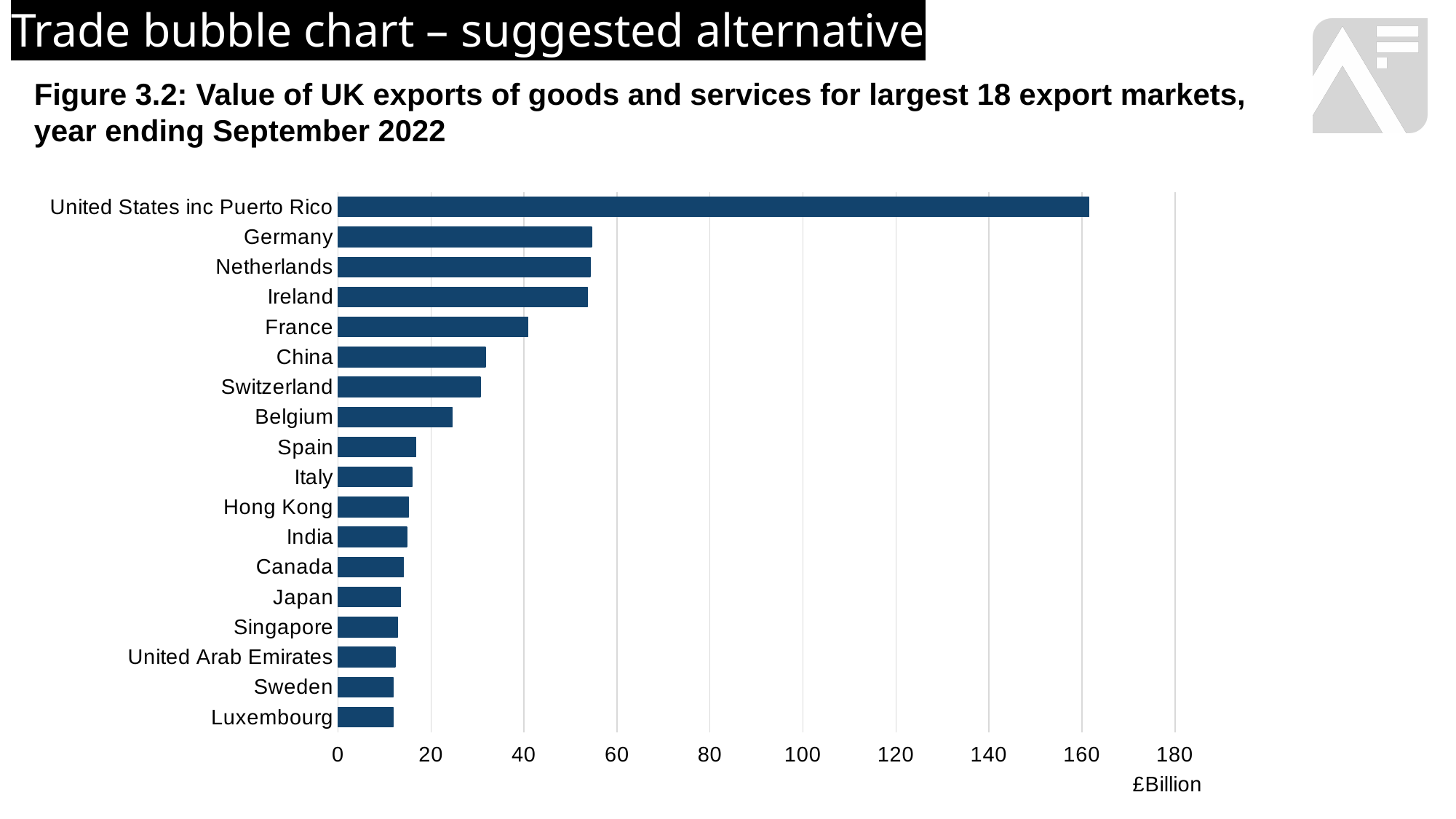
Which export market has the highest value of UK exports? United States inc Puerto Rico Is the value for United States inc Puerto Rico greater or less than 140? greater Is the value for France greater or less than 60? less Is the value for Germany greater or less than 60? less How many export markets are plotted in the chart? 18 Which has a larger value of UK exports, Belgium or Spain? Belgium What unit is shown on the x axis of the chart? £Billion What kind of chart is shown on the slide? bar chart Which has a larger value of UK exports, France or China? France